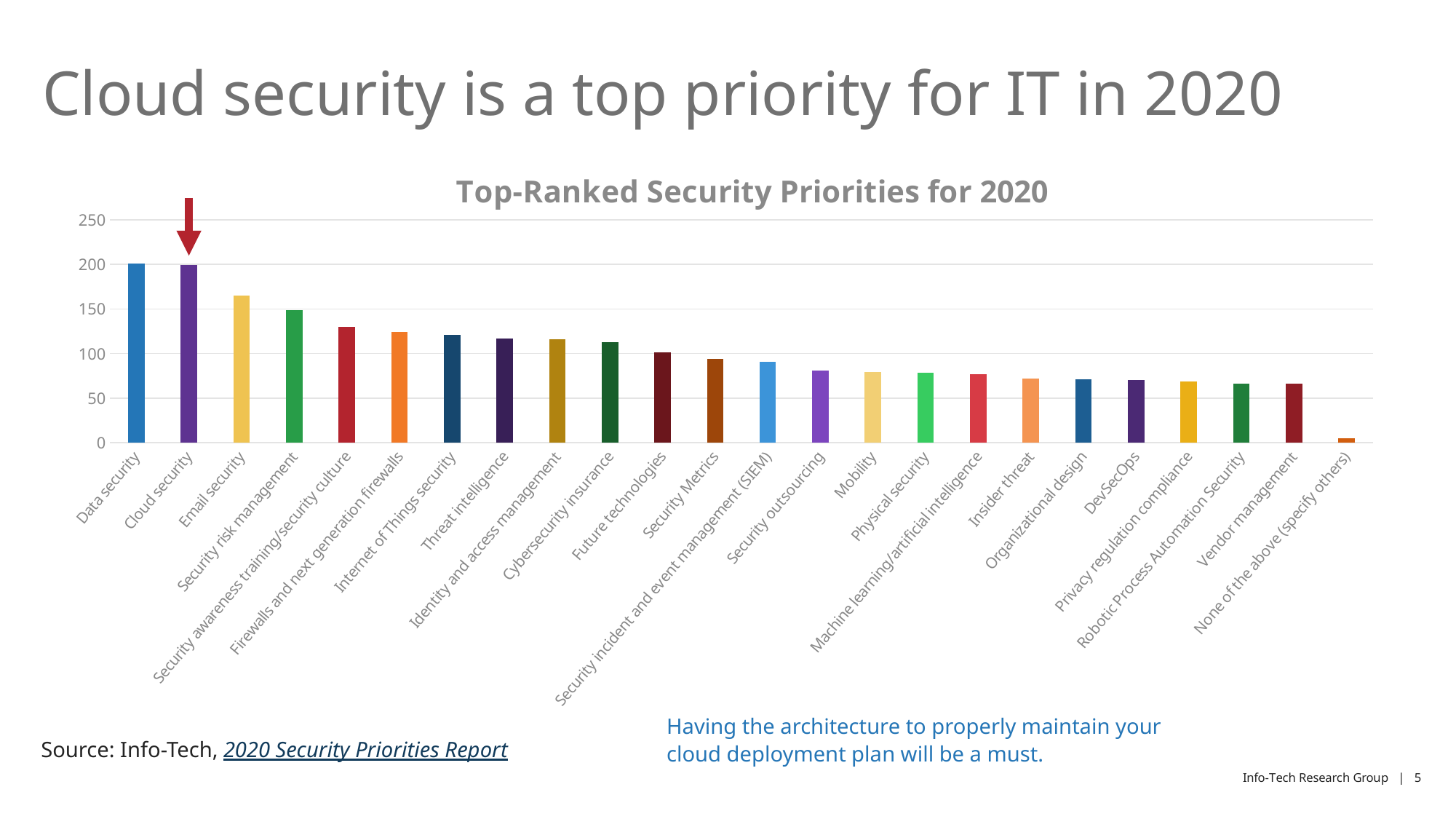
How many categories are plotted in the chart? 24 Is the value for Firewalls and next generation firewalls greater or less than 100? greater Which category has the lowest value in the chart? None of the above (specify others) Is the value for Email security greater or less than 150? greater Do the values rise or fall moving from left to right along the x axis? fall What is the title of the chart? Top-Ranked Security Priorities for 2020 Which has a larger value, Email security or Security risk management? Email security Is the value for Security Metrics greater or less than 100? less What kind of chart is shown on the slide? bar chart Which category does the red arrow above the chart point to? Cloud security